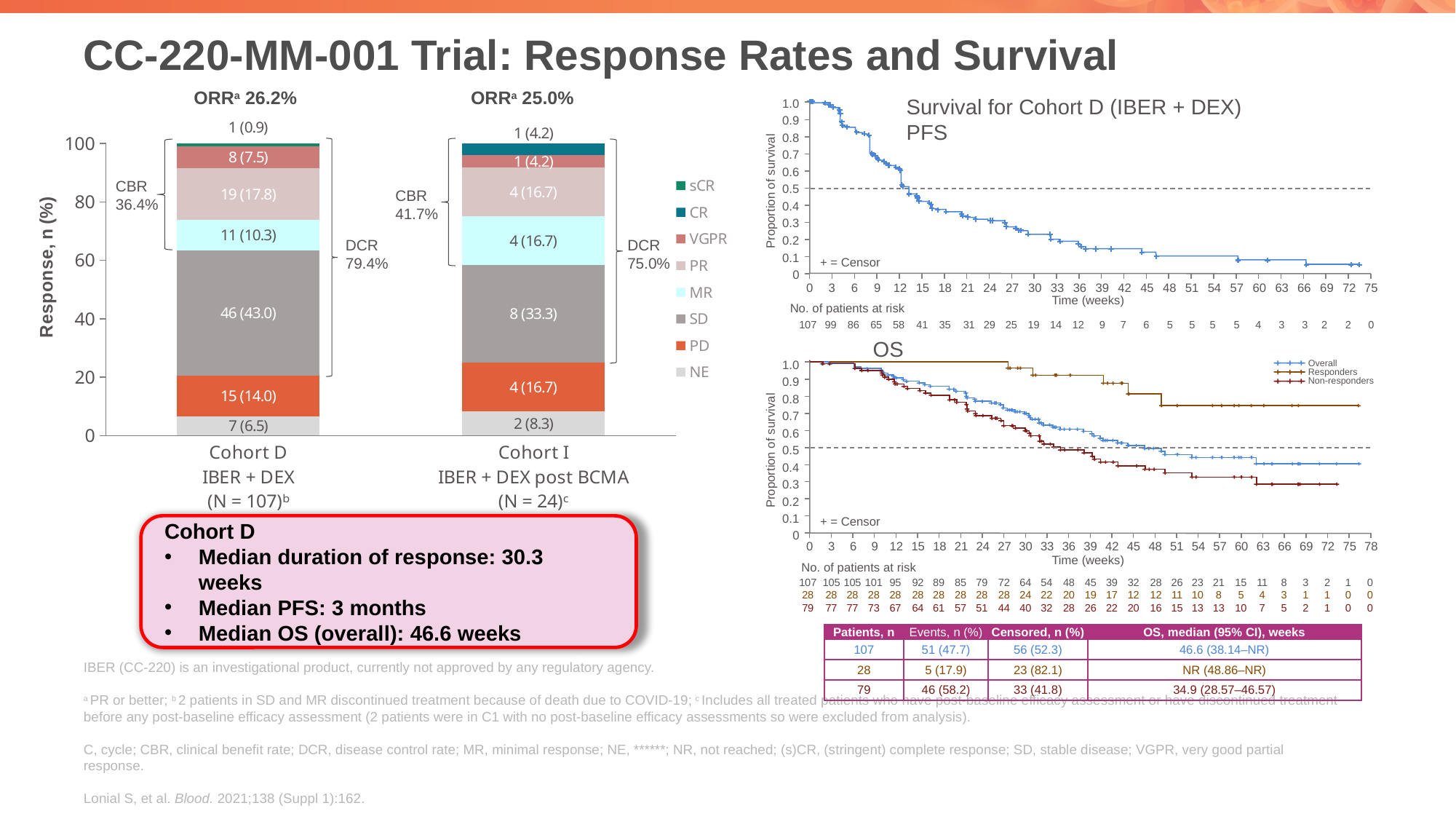
How many cohorts (bars) are shown in the response rate bar chart? 2 In the response rate bar chart, what is the value labelled for PD in Cohort I? 4 (16.7) In the response rate bar chart, what is the value labelled for SD in Cohort D? 46 (43.0) In the response rate bar chart, which cohort has more patients with PD, Cohort D or Cohort I? Cohort D What ORR is shown above the Cohort D bar in the response rate chart? 26.2% In the PFS survival chart for Cohort D, how many patients are at risk at 12 weeks? 58 What DCR is shown for Cohort I in the response rate chart? 75.0% How many response categories does the legend of the response rate bar chart list? 8 What kind of chart is used to show the response rates for Cohort D and Cohort I? Stacked bar chart How many series does the legend of the OS survival chart list? 3 In the response rate bar chart, which response category has the largest segment in the Cohort D bar? SD In the PFS survival chart for Cohort D, is the proportion of survival at 24 weeks greater or less than 0.5? less